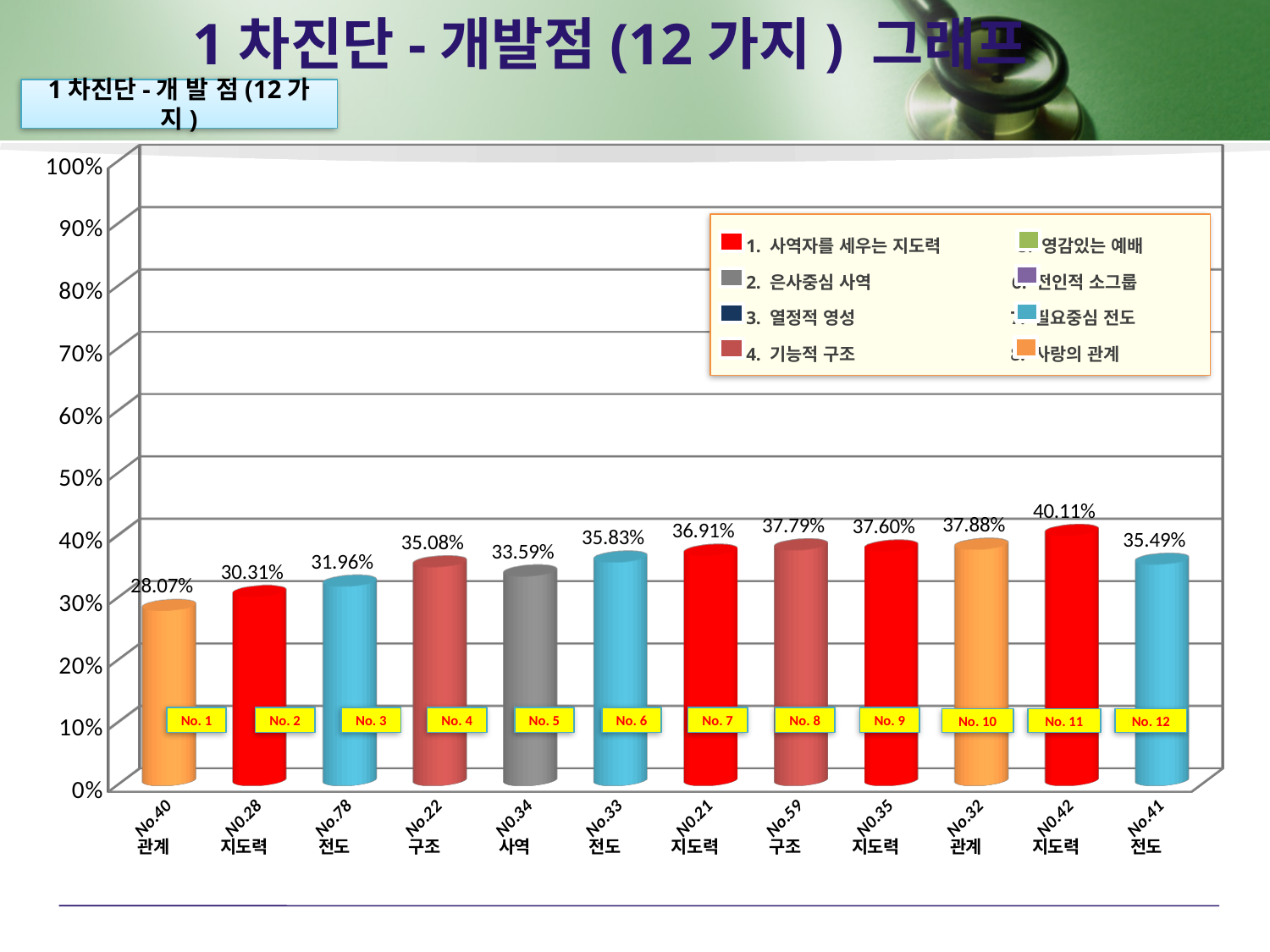
What is the value shown for the bar labeled No. 11 (N0.42 지도력)? 40.11% Which has a larger value, No. 4 (No.22 구조) or No. 5 (N0.34 사역)? No. 4 (No.22 구조) Is the value for No. 1 (No.40 관계) greater or less than 30%? less How many bars are plotted in the chart? 12 What is the difference between the values for No. 4 (35.08%) and No. 3 (31.96%)? 3.12% Which bar has the highest value? No. 11 (N0.42 지도력) What is the value shown for the bar labeled No. 8 (No.59 구조)? 37.79% Which bar has the lowest value? No. 1 (No.40 관계) What kind of chart is shown on the slide? bar chart What is the value shown for the bar labeled No. 1 (No.40 관계)? 28.07% What is the difference between the values for No. 11 (40.11%) and No. 1 (28.07%)? 12.04% What is the value shown for the bar labeled No. 4 (No.22 구조)? 35.08%